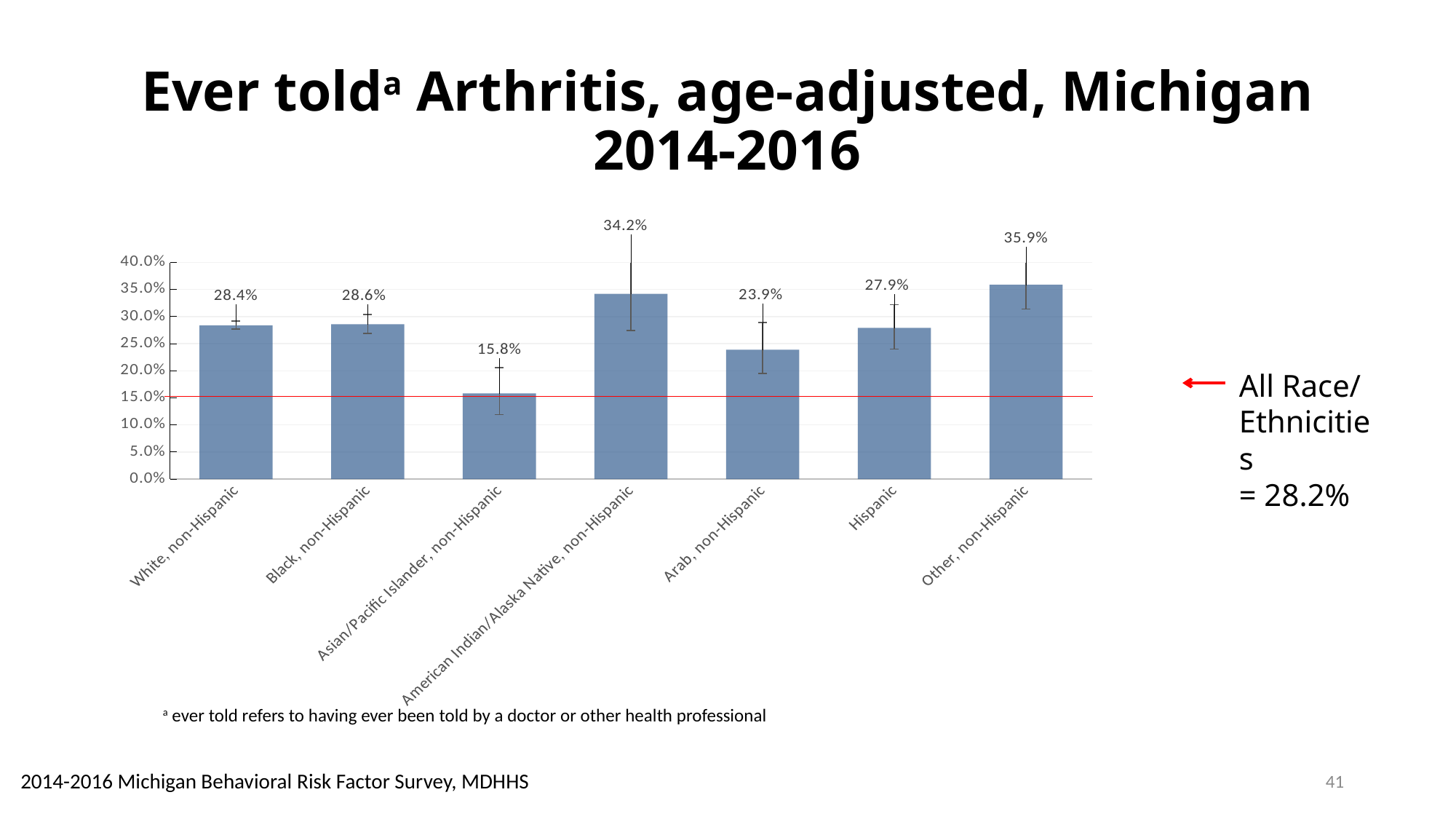
How many race/ethnicity categories are shown on the chart? 7 Which category has the highest value? Other, non-Hispanic Which category has the lowest value? Asian/Pacific Islander, non-Hispanic Which is larger, the value for American Indian/Alaska Native, non-Hispanic or the value for Arab, non-Hispanic? American Indian/Alaska Native, non-Hispanic What is the value for Hispanic? 27.9% What is the value for All Race/Ethnicities noted beside the chart? 28.2% What is the difference between the values for Other, non-Hispanic and Asian/Pacific Islander, non-Hispanic? 20.1% What is the value for Asian/Pacific Islander, non-Hispanic? 15.8% What is the value for White, non-Hispanic? 28.4% What is the difference between the values for Black, non-Hispanic and White, non-Hispanic? 0.2% What is the value for Arab, non-Hispanic? 23.9% What kind of chart is shown on the slide? Bar chart